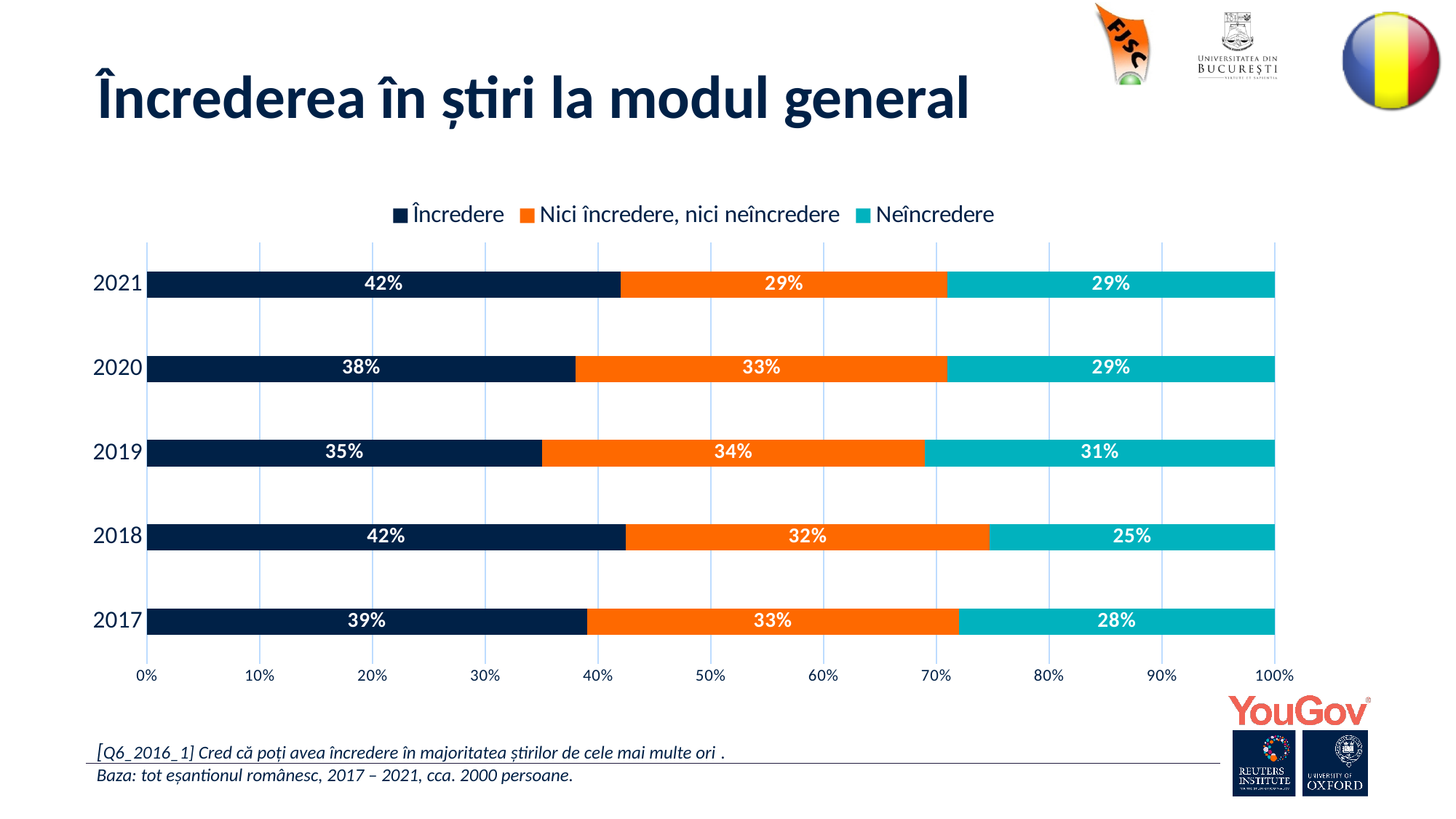
In which year is the Încredere value lowest? 2019 What is the value for Neîncredere in 2018? 25% What is the total of the three segments for the 2018 bar? 99% How many series does the legend list? 3 What is the value for Nici încredere, nici neîncredere in 2019? 34% What kind of chart is shown on the slide? stacked bar chart In which year is the Neîncredere value highest? 2019 What is the difference between the Încredere value in 2021 and in 2019? 7 percentage points What is the value for Încredere in 2021? 42% Which is larger: the Încredere value in 2020 or in 2017? 2017 In which year is the Neîncredere value lowest? 2018 How many years are shown on the chart? 5